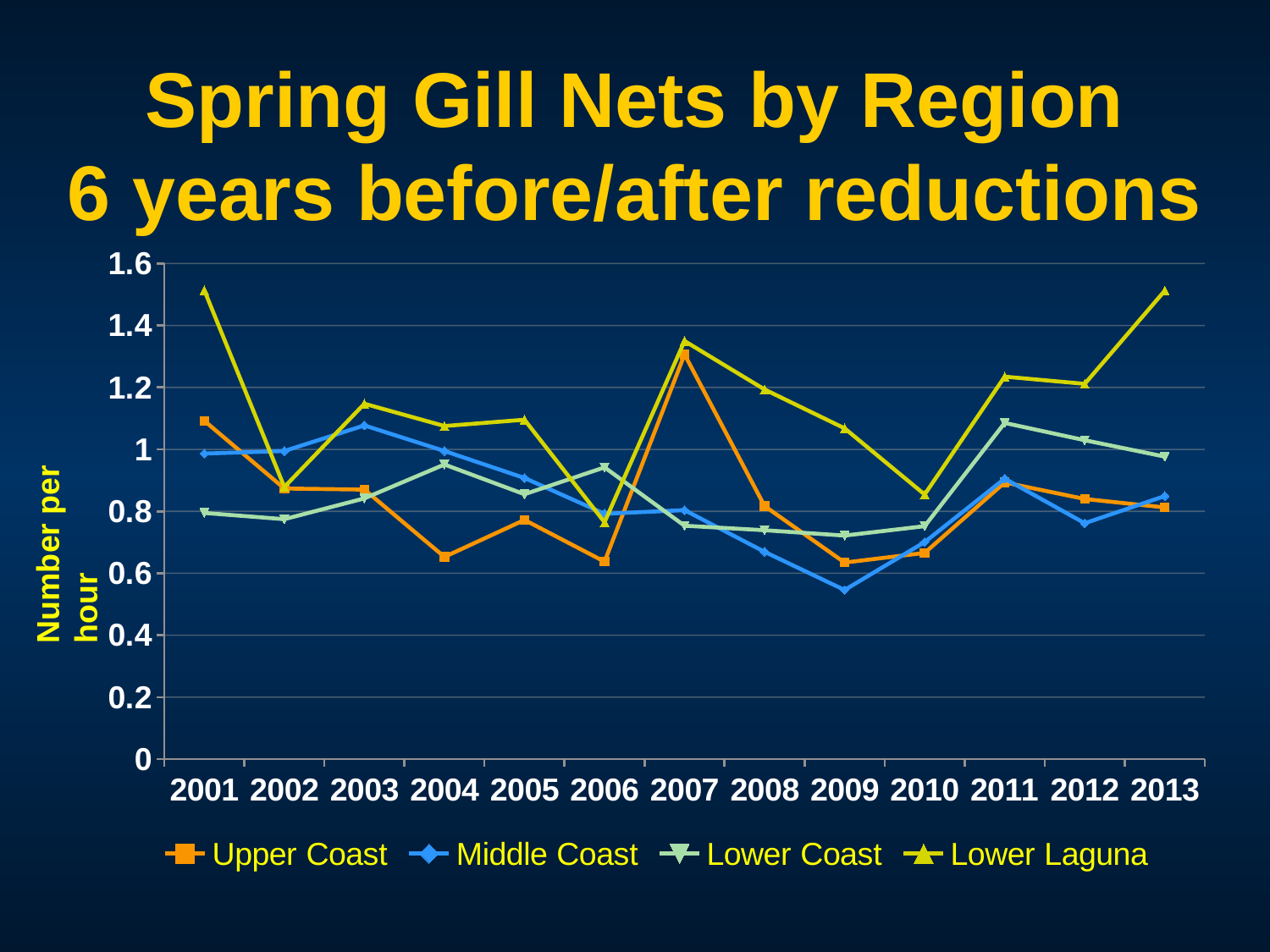
Is the value for Lower Laguna in 2001 greater or less than 1.4? greater Which series has the lowest value in 2009? Middle Coast What is the label on the y axis? Number per hour Is the value for Upper Coast in 2004 greater or less than 0.8? less Does the Lower Laguna line rise or fall from 2010 to 2013? Rises Is the value for Lower Coast in 2011 greater or less than 1? greater What kind of chart is shown on the slide? Line chart In 2003, which is larger: the value for Middle Coast or the value for Upper Coast? Middle Coast How many series does the legend list? 4 How many years are shown along the x axis? 13 Which series has the highest value in 2013? Lower Laguna